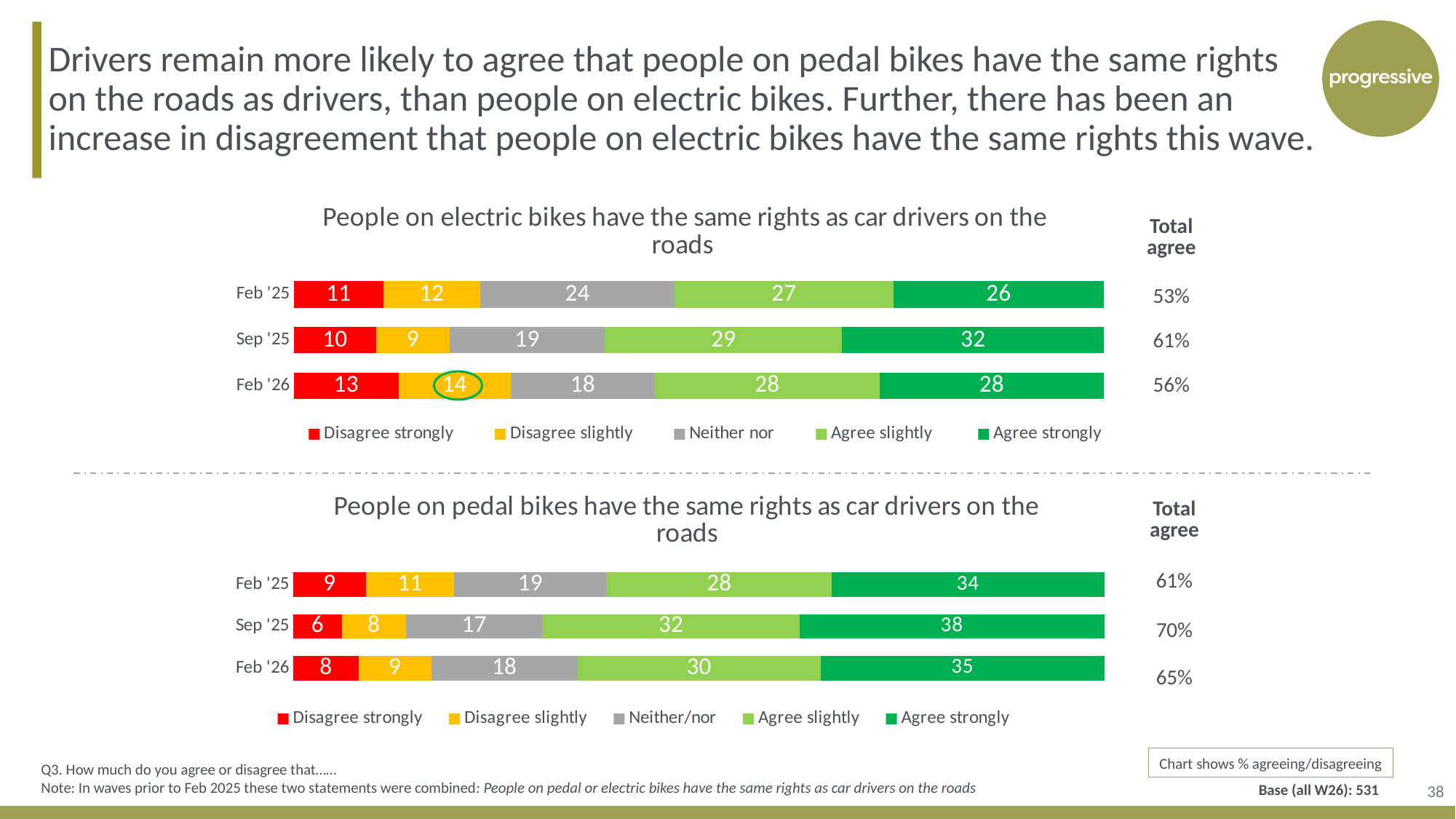
In the 'People on electric bikes have the same rights as car drivers on the roads' chart, what is the value for Disagree slightly in Feb '26? 14 How many series does the legend of the 'People on pedal bikes have the same rights as car drivers on the roads' chart list? 5 What kind of chart is the 'People on electric bikes have the same rights as car drivers on the roads' chart? Stacked bar chart In the 'People on electric bikes have the same rights as car drivers on the roads' chart, which wave has the highest Disagree strongly value? Feb '26 How many waves (bars) are shown in the 'People on electric bikes have the same rights as car drivers on the roads' chart? 3 In the 'People on pedal bikes have the same rights as car drivers on the roads' chart, is the Agree strongly value larger in Sep '25 or Feb '26? Sep '25 In the 'People on electric bikes have the same rights as car drivers on the roads' chart, what is the value for Agree strongly in Sep '25? 32 In the 'People on pedal bikes have the same rights as car drivers on the roads' chart, what is the Total agree figure for Sep '25? 70% In the 'People on electric bikes have the same rights as car drivers on the roads' chart, what is the difference between the Agree strongly values for Sep '25 and Feb '25? 6 In the 'People on pedal bikes have the same rights as car drivers on the roads' chart, what is the value for Neither/nor in Sep '25? 17 In the 'People on pedal bikes have the same rights as car drivers on the roads' chart, which wave has the lowest Disagree strongly value? Sep '25 In the 'People on pedal bikes have the same rights as car drivers on the roads' chart, what is the value for Agree slightly in Feb '26? 30